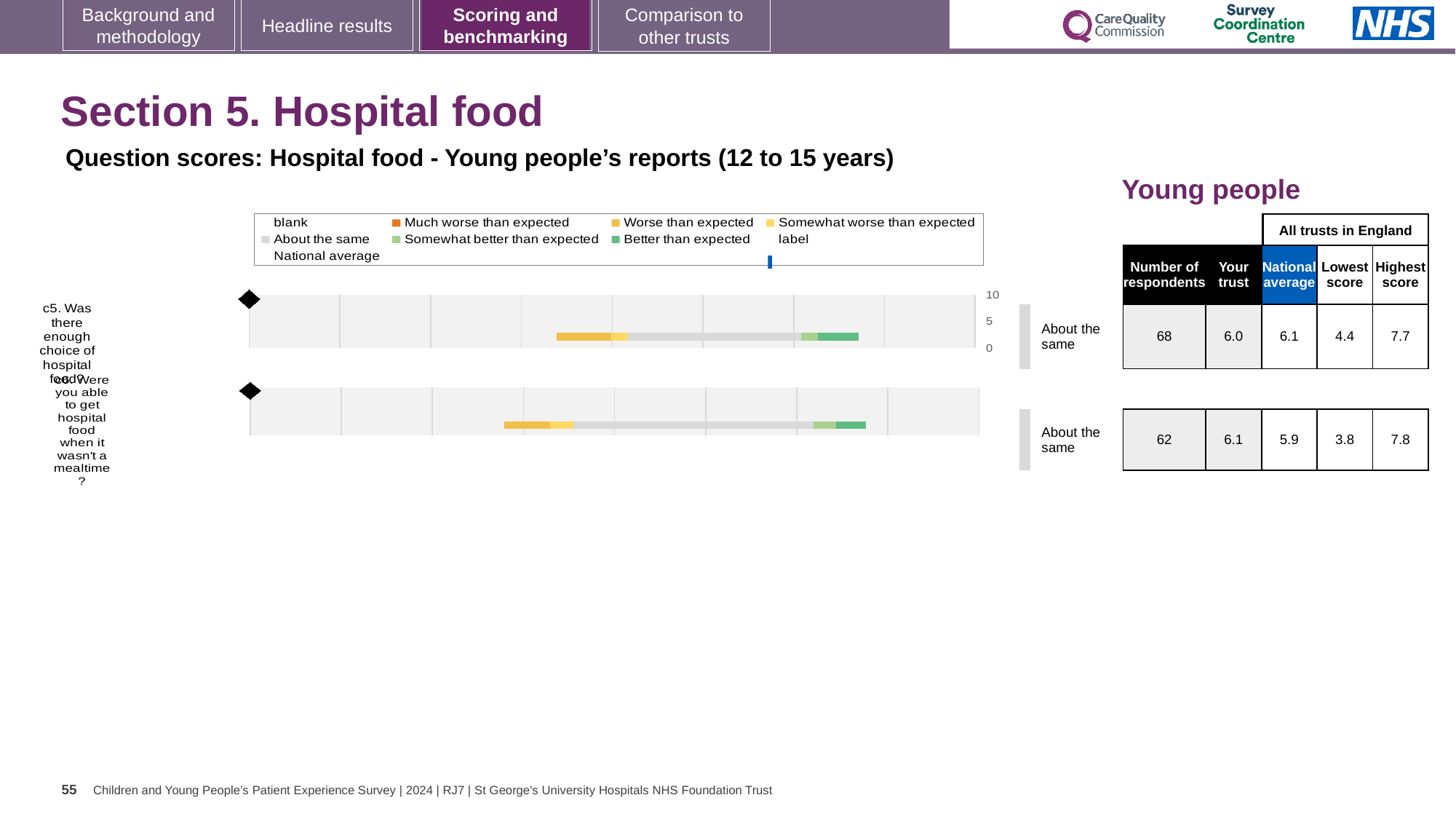
What is the maximum value shown on the chart's axis? 10 What is the difference between the highest and lowest trust scores for question c6? 4.0 What is the national average score for question c6 (able to get hospital food when it wasn't a mealtime)? 5.9 How many questions (bars) are plotted in the hospital food chart? 2 Which question has the higher 'Your trust' score, c5 or c6? c6 What benchmark category is given for question c5 (enough choice of hospital food)? About the same Which question has the lower lowest score across all trusts in England, c5 or c6? c6 Which legend entry is shown with a dark green colour? Better than expected What type of chart is used to show the question scores for c5 and c6? bar chart What is the highest score across all trusts in England for question c5? 7.7 What is the 'Your trust' score for question c5 (enough choice of hospital food)? 6.0 How many respondents answered question c6? 62